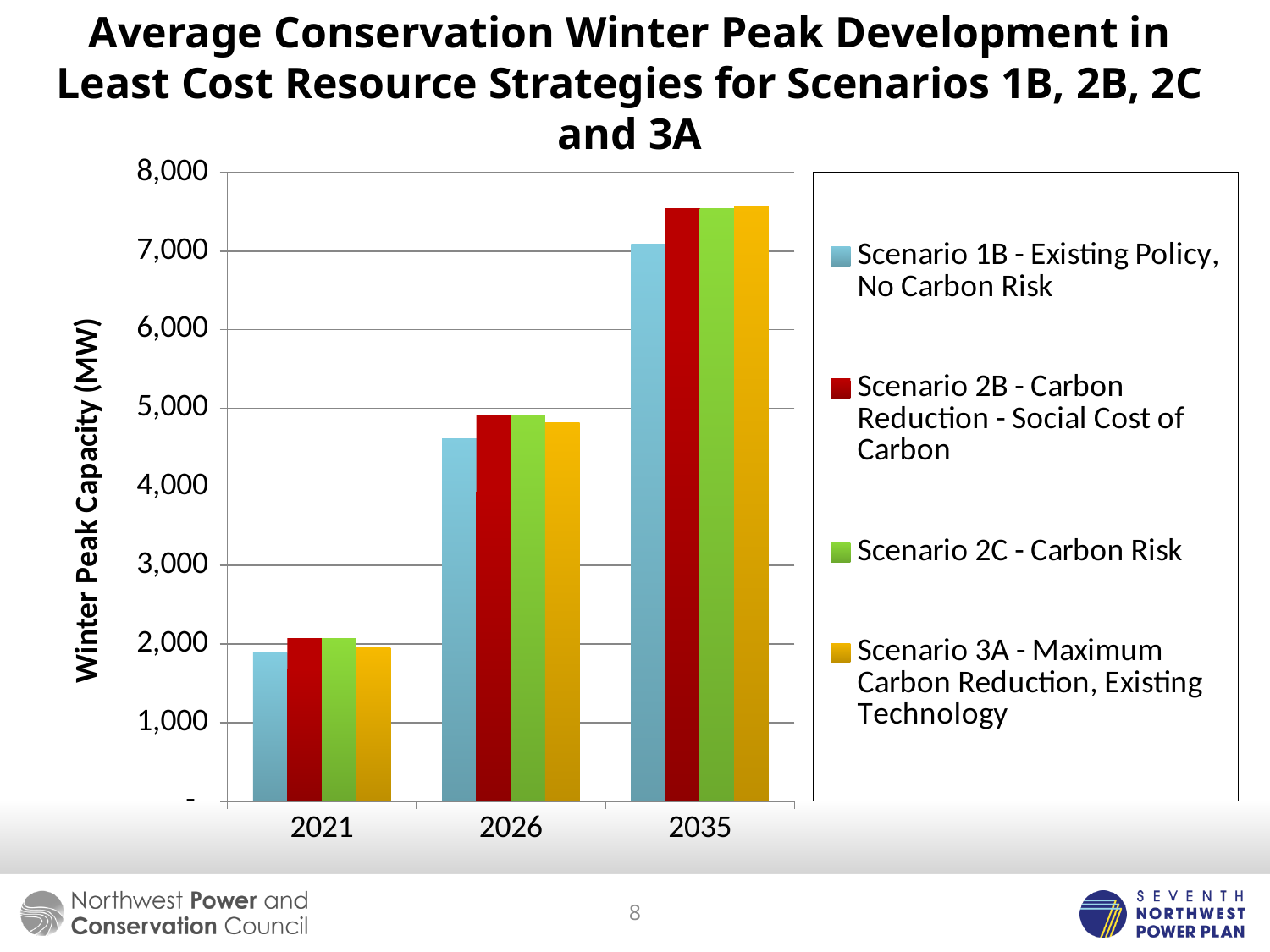
Which colour represents Scenario 2C - Carbon Risk in the legend? green Is the value for Scenario 3A in 2035 greater or less than 8,000? less Is the value for Scenario 1B in 2026 greater or less than 5,000? less Is the value for Scenario 1B in 2035 greater or less than 7,000? greater In 2026, which is larger: Scenario 1B or Scenario 2B? Scenario 2B How many years are shown on the x axis? 3 Do the values for Scenario 1B rise or fall from 2021 to 2035? rise In 2035, which scenario has the lowest winter peak capacity? Scenario 1B How many scenarios does the legend list? 4 What is the label on the vertical axis? Winter Peak Capacity (MW) What kind of chart is shown on the slide? bar chart